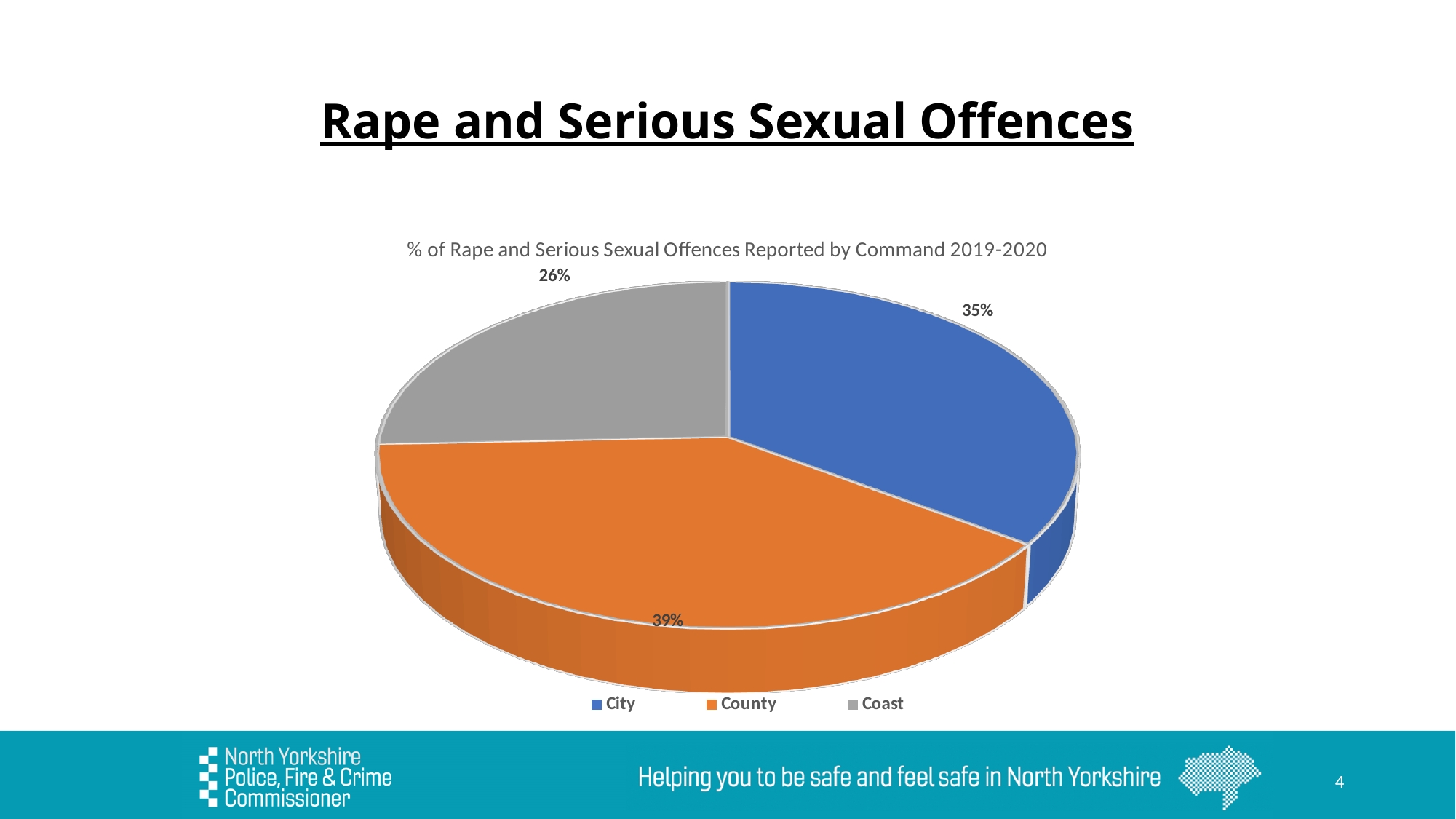
Which is larger, the share for City or the share for Coast? City Which command has the largest share of the pie? County What is the difference in percentage points between the County and Coast shares? 13 What is the difference in percentage points between the County and City shares? 4 What colour is the County slice in the pie chart? Orange Which command has the smallest share of the pie? Coast What percentage of rape and serious sexual offences were reported by the City command? 35% What is the title of the chart? % of Rape and Serious Sexual Offences Reported by Command 2019-2020 What kind of chart is shown on the slide? Pie chart What percentage of rape and serious sexual offences were reported by the Coast command? 26% How many commands are shown in the pie chart? 3 What percentage of rape and serious sexual offences were reported by the County command? 39%